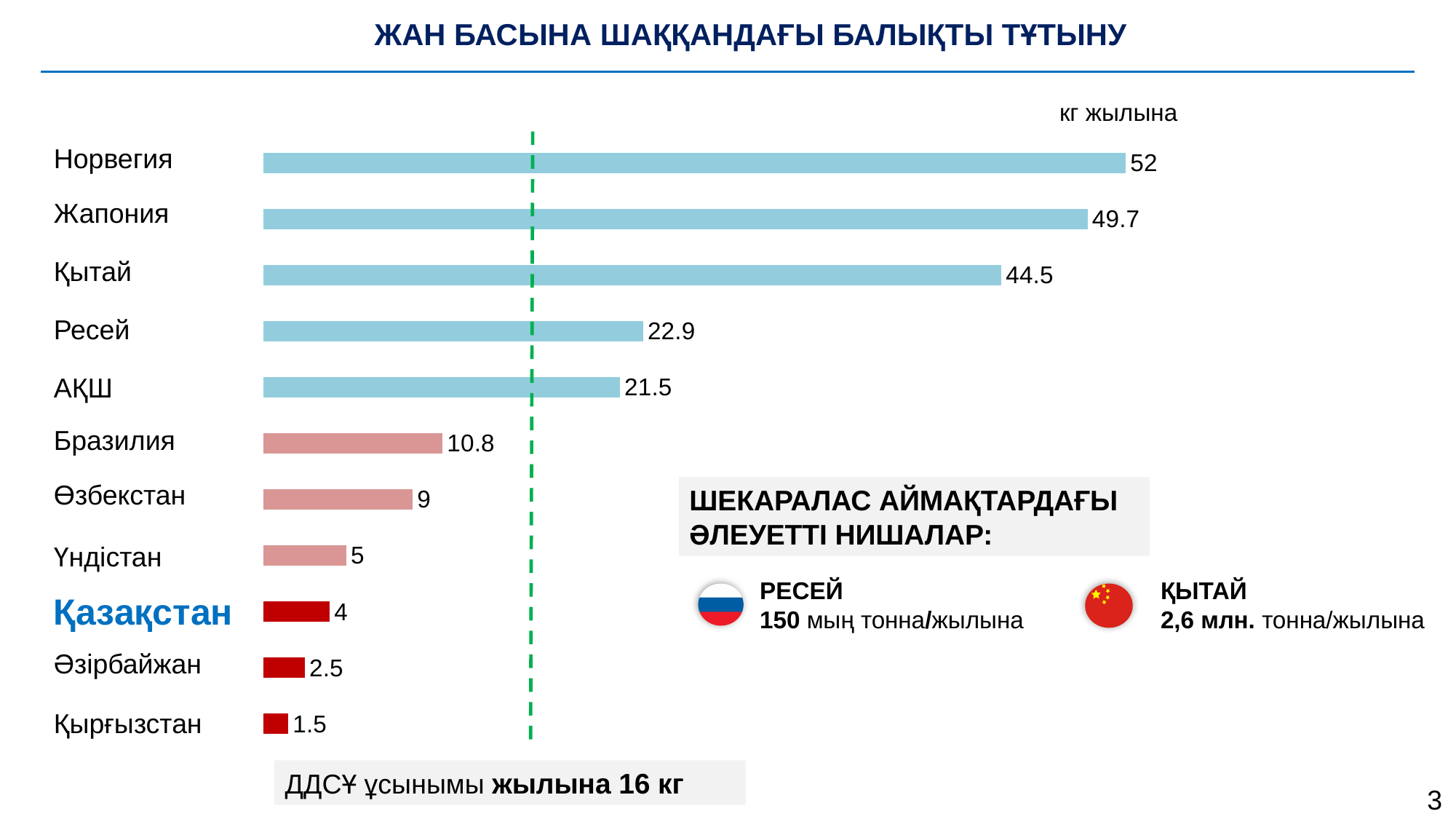
What is the value for Қазақстан? 4 Which category has the highest value? Норвегия What is the value for Ресей? 22.9 How many categories are shown in the chart? 11 What is the difference between the values for Жапония and Қытай? 5.2 What is the value for Норвегия? 52 What is the difference between the values for Ресей and АҚШ? 1.4 Which category has the lowest value? Қырғызстан What value does the dashed green line (ДДСҰ ұсынымы) mark? 16 кг What kind of chart is shown on the slide? Bar chart Which is larger, the value for Бразилия or the value for Өзбекстан? Бразилия What unit is indicated for the values in the chart? кг жылына